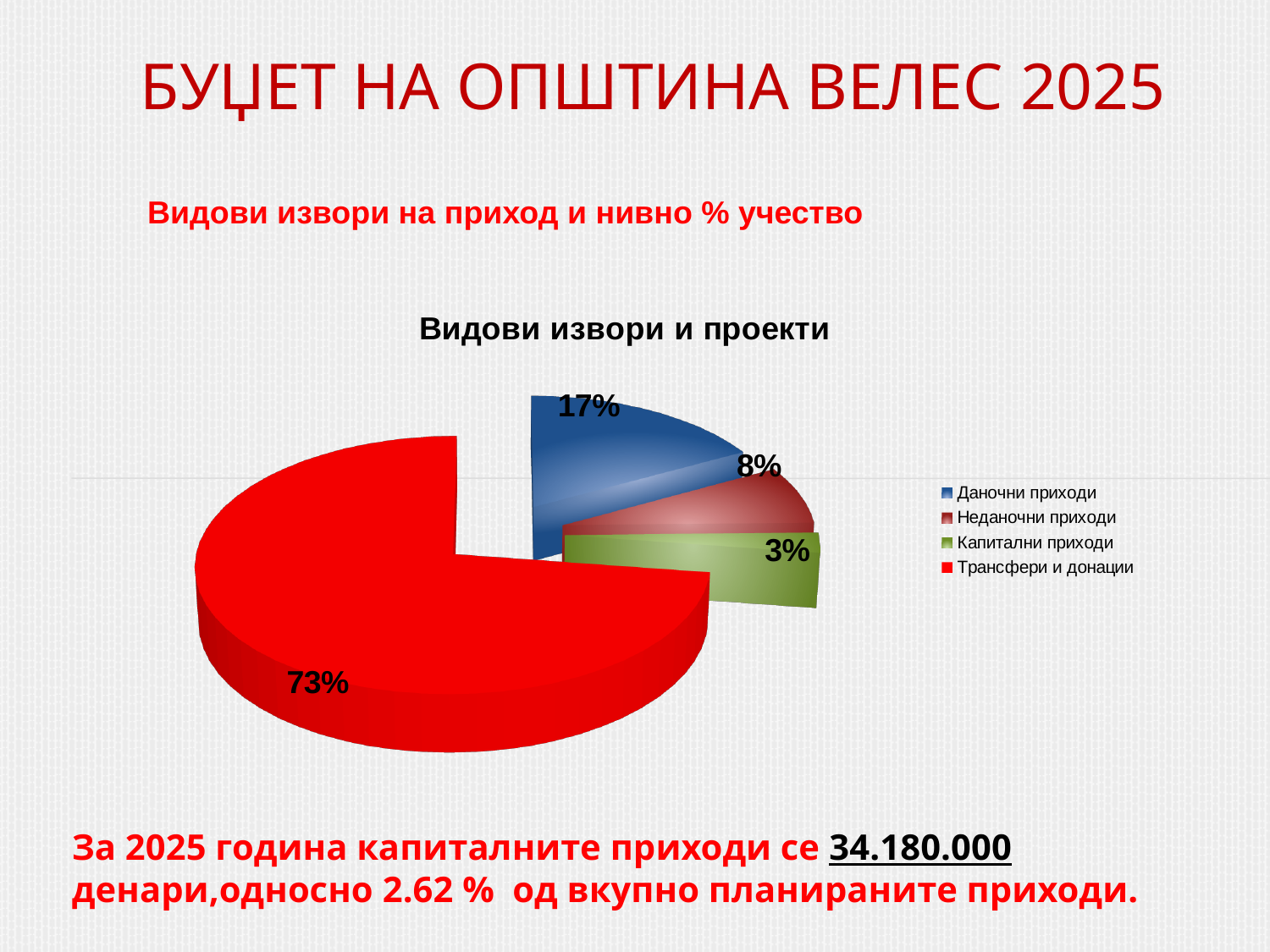
How many entries does the legend list? 4 How many slices does the pie chart have? 4 What share of the pie is Неданочни приходи? 8% What is the difference in percentage points between Даночни приходи and Неданочни приходи? 9 percentage points What kind of chart is shown on the slide? Pie chart What share of the pie is Трансфери и донации? 73% Which category has the smallest share of the pie? Капитални приходи What share of the pie is Капитални приходи? 3% What is the title of the chart? Видови извори и проекти Which category has the largest share of the pie? Трансфери и донации Which is larger, the share for Даночни приходи or the share for Капитални приходи? Даночни приходи